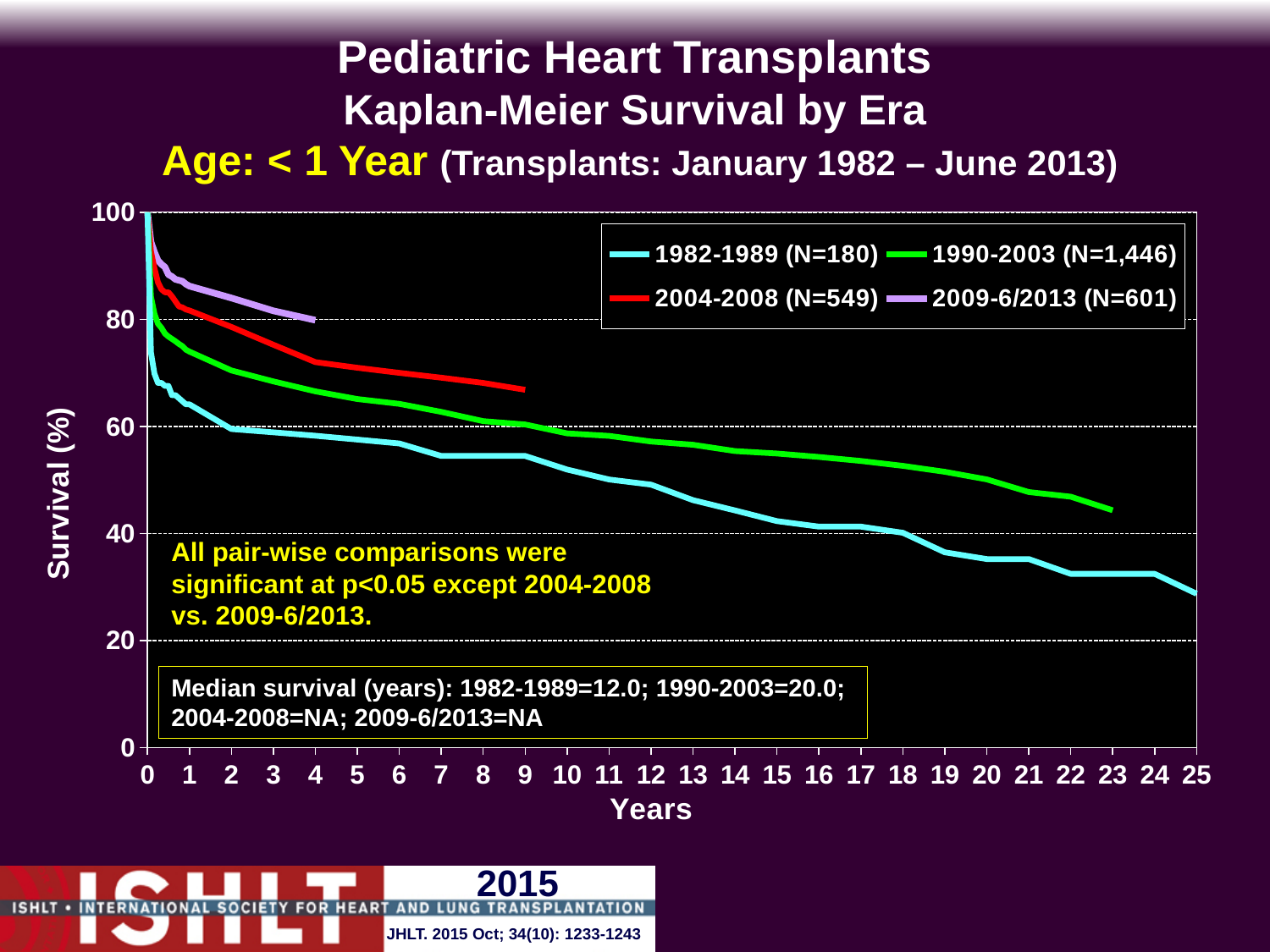
Is the survival for the 1982-1989 era at 25 years greater or less than 40? less What is the number of transplants (N) for the 2009-6/2013 era shown in the legend? 601 Which era has the lowest survival curve across the chart? 1982-1989 Do the survival curves rise or fall as years increase? Fall What is the median survival in years for the 1990-2003 era? 20.0 How many series (eras) does the legend list? 4 Is the survival for the 2004-2008 era at 9 years greater or less than 60? greater Which era has the highest survival curve over the years it is plotted? 2009-6/2013 At 5 years, which era has higher survival: 2004-2008 or 1982-1989? 2004-2008 What is the median survival in years for the 1982-1989 era? 12.0 What kind of chart is shown on the slide? Line chart What is the number of transplants (N) for the 1990-2003 era shown in the legend? 1,446